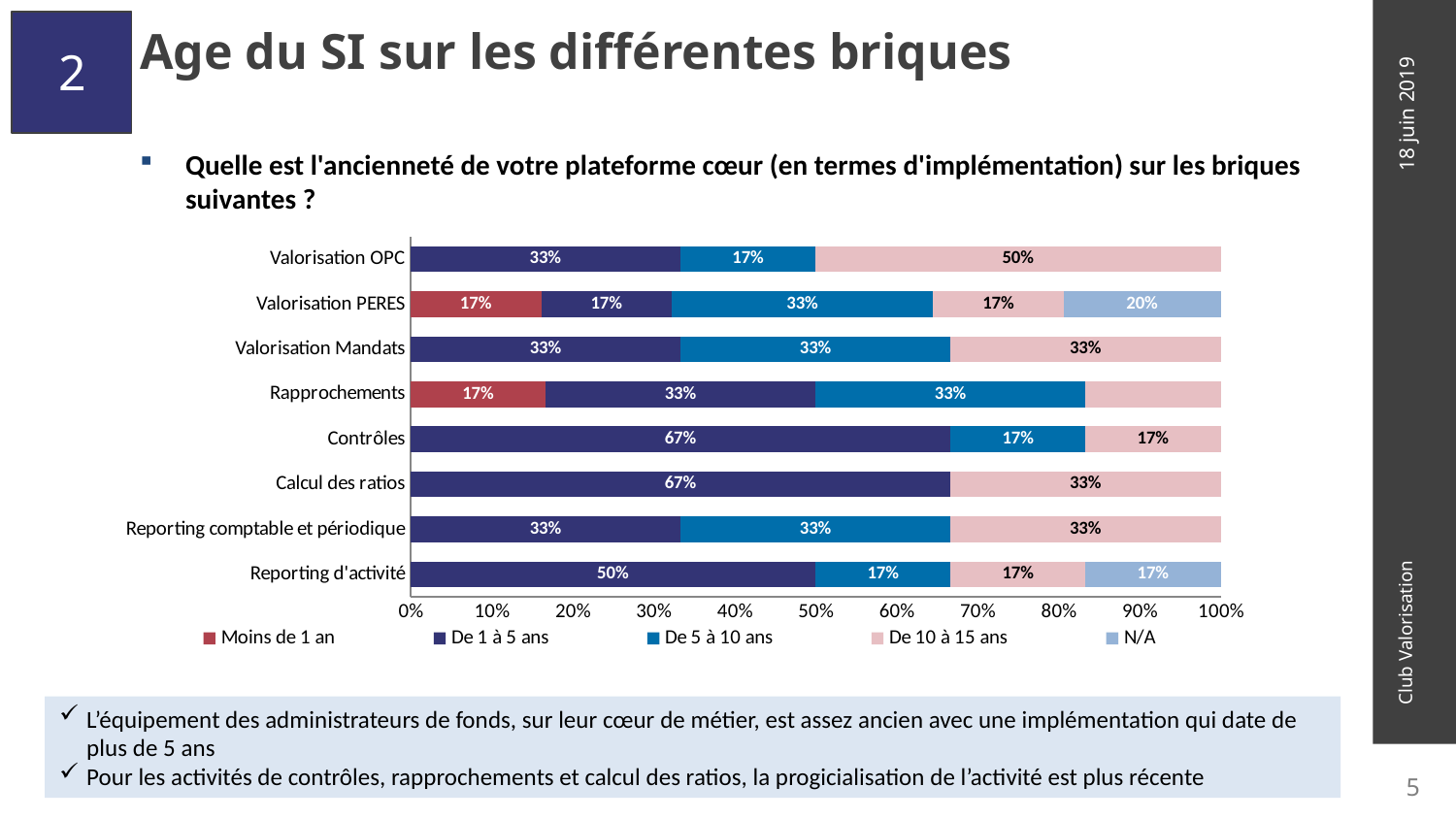
How many categories (briques) are plotted on the chart? 8 What is the value of 'N/A' for Valorisation PERES? 20% What is the last legend entry of the chart? N/A How many series does the legend list? 5 Which is larger: the 'De 1 à 5 ans' value for Reporting d'activité or the 'De 1 à 5 ans' value for Valorisation Mandats? Reporting d'activité What is the difference between the 'De 1 à 5 ans' value for Calcul des ratios and the 'De 10 à 15 ans' value for Calcul des ratios? 34% What is the value of 'De 10 à 15 ans' for Valorisation OPC? 50% What is the value of 'Moins de 1 an' for Rapprochements? 17% Which categories show a 'Moins de 1 an' segment? Valorisation PERES and Rapprochements What is the value of 'De 1 à 5 ans' for Contrôles? 67% What kind of chart is shown on the slide? Stacked bar chart Which category has the highest value for 'De 10 à 15 ans'? Valorisation OPC